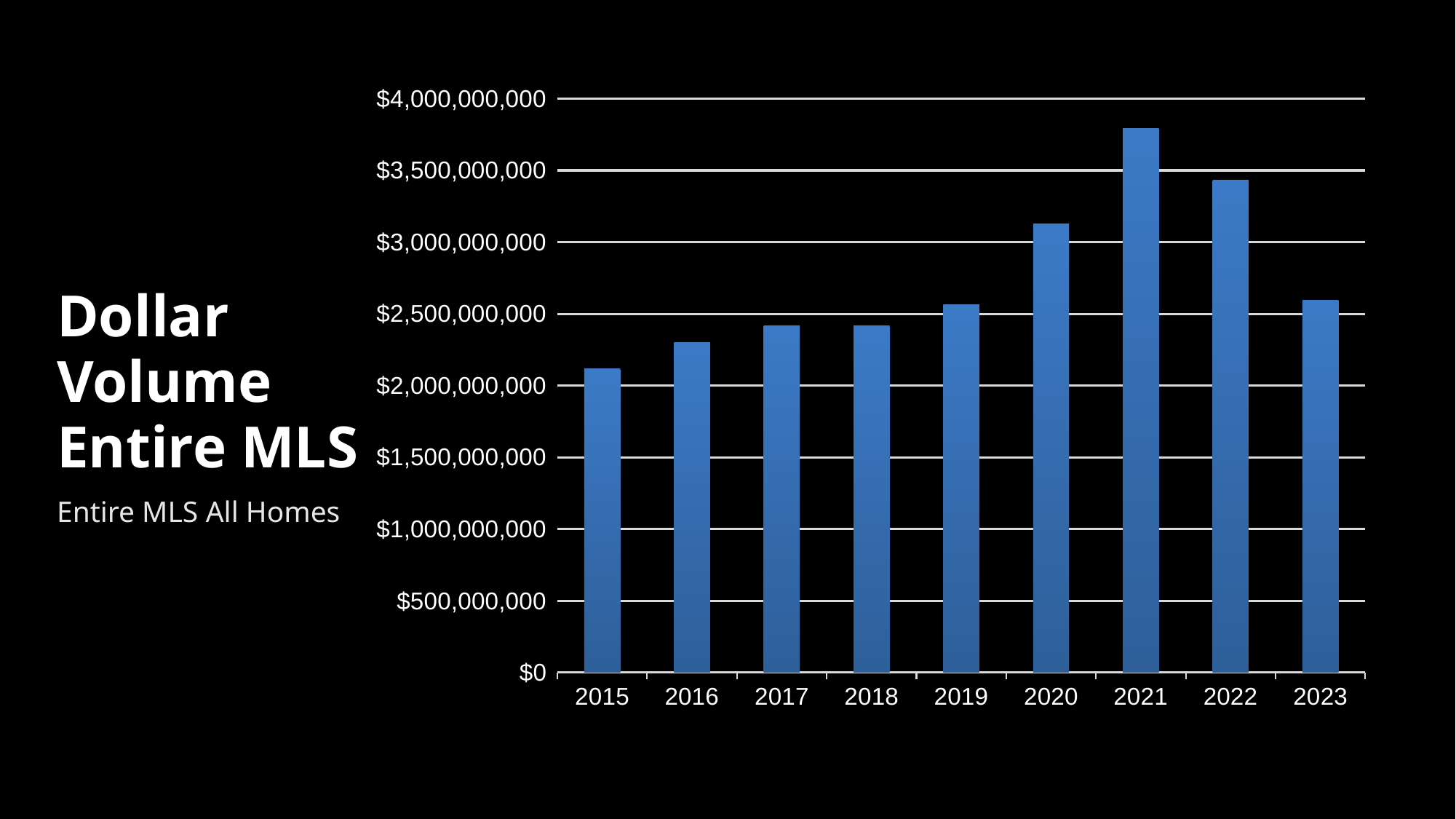
Which year has the highest dollar volume? 2021 Which year has the lowest dollar volume? 2015 What kind of chart is shown on the slide? bar chart Is the dollar volume for 2020 greater or less than $3,000,000,000? greater Which year has the larger dollar volume, 2016 or 2019? 2019 How many years are shown on the x axis of the chart? 9 Is the dollar volume for 2015 greater or less than $2,000,000,000? greater Is the dollar volume for 2022 greater or less than $3,500,000,000? less Does the dollar volume rise or fall from 2015 to 2021? rise Which year has the larger dollar volume, 2020 or 2022? 2022